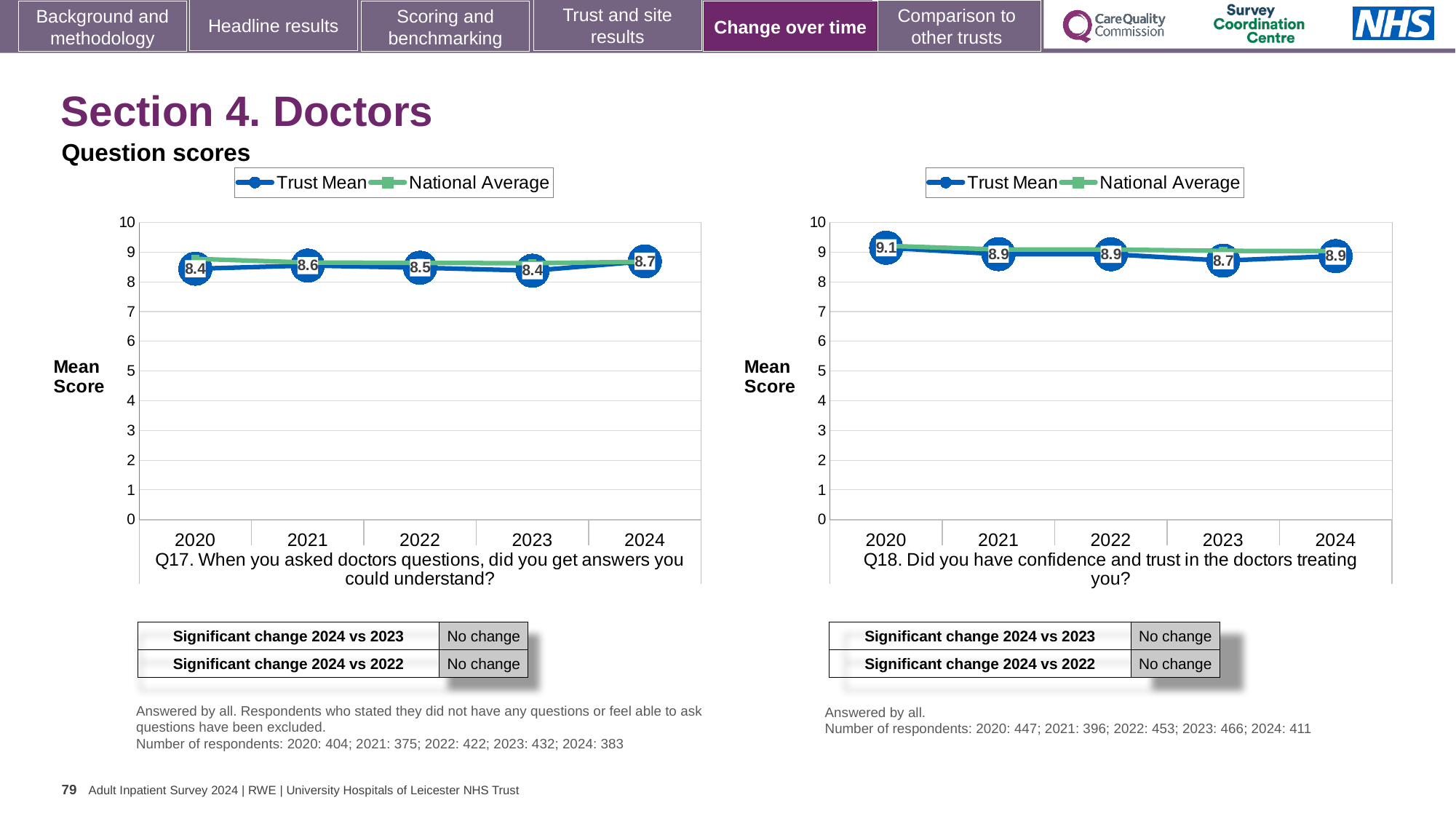
In the Q18 chart (right), what is the Trust Mean score for 2023? 8.7 In the Q18 chart (right), which year has the lowest Trust Mean score? 2023 How many years are plotted on the x axis of the Q18 chart (right)? 5 How many series does the legend of the Q17 chart (left) list? 2 In the Q18 chart (right), what is the difference between the Trust Mean scores for 2020 and 2023? 0.4 In the Q17 chart (left), what is the Trust Mean score for 2020? 8.4 In the Q18 chart (right), what is the Trust Mean score for 2020? 9.1 In the Q17 chart (left), is the Trust Mean score for 2021 greater or less than 8? greater In the Q17 chart (left), what is the Trust Mean score for 2024? 8.7 In the Q17 chart (left), what is the difference between the Trust Mean scores for 2024 and 2023? 0.3 In the Q17 chart (left), which year has the highest Trust Mean score? 2024 What type of chart is the Q18 chart (right)? Line chart